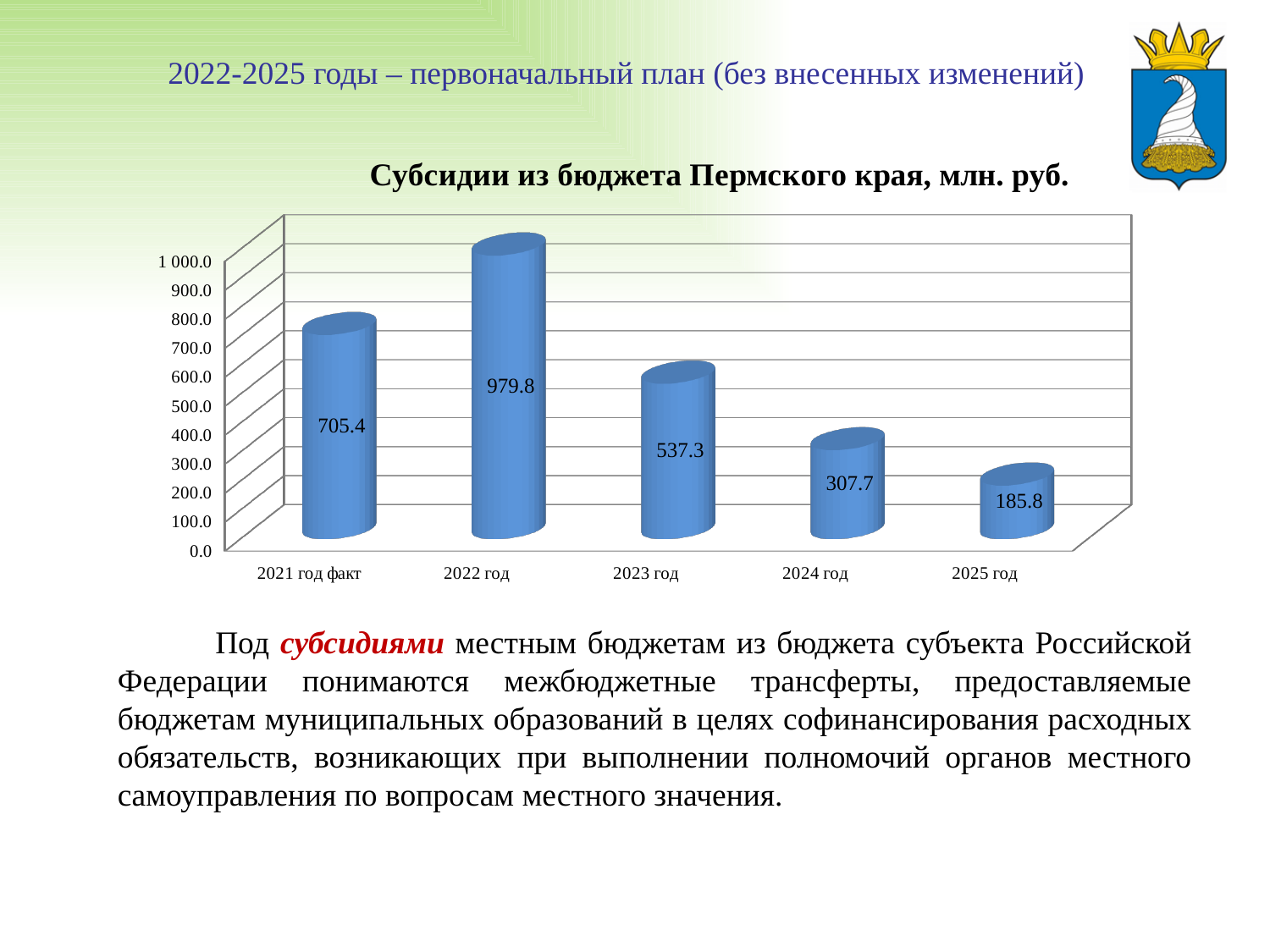
Which category has the lowest value? 2025 год What is the difference between the values for 2022 год and 2023 год? 442.5 What is the value for 2021 год факт? 705.4 What is the value for 2024 год? 307.7 Which is larger, the value for 2021 год факт or the value for 2023 год? 2021 год факт How many categories are shown on the x axis? 5 What is the value for 2025 год? 185.8 Is the value for 2024 год greater or less than 400.0? less What kind of chart is shown on the slide? bar chart Do the values rise or fall from 2022 год to 2025 год? fall Which category has the highest value? 2022 год What is the value for 2022 год in the chart 'Субсидии из бюджета Пермского края, млн. руб.'? 979.8